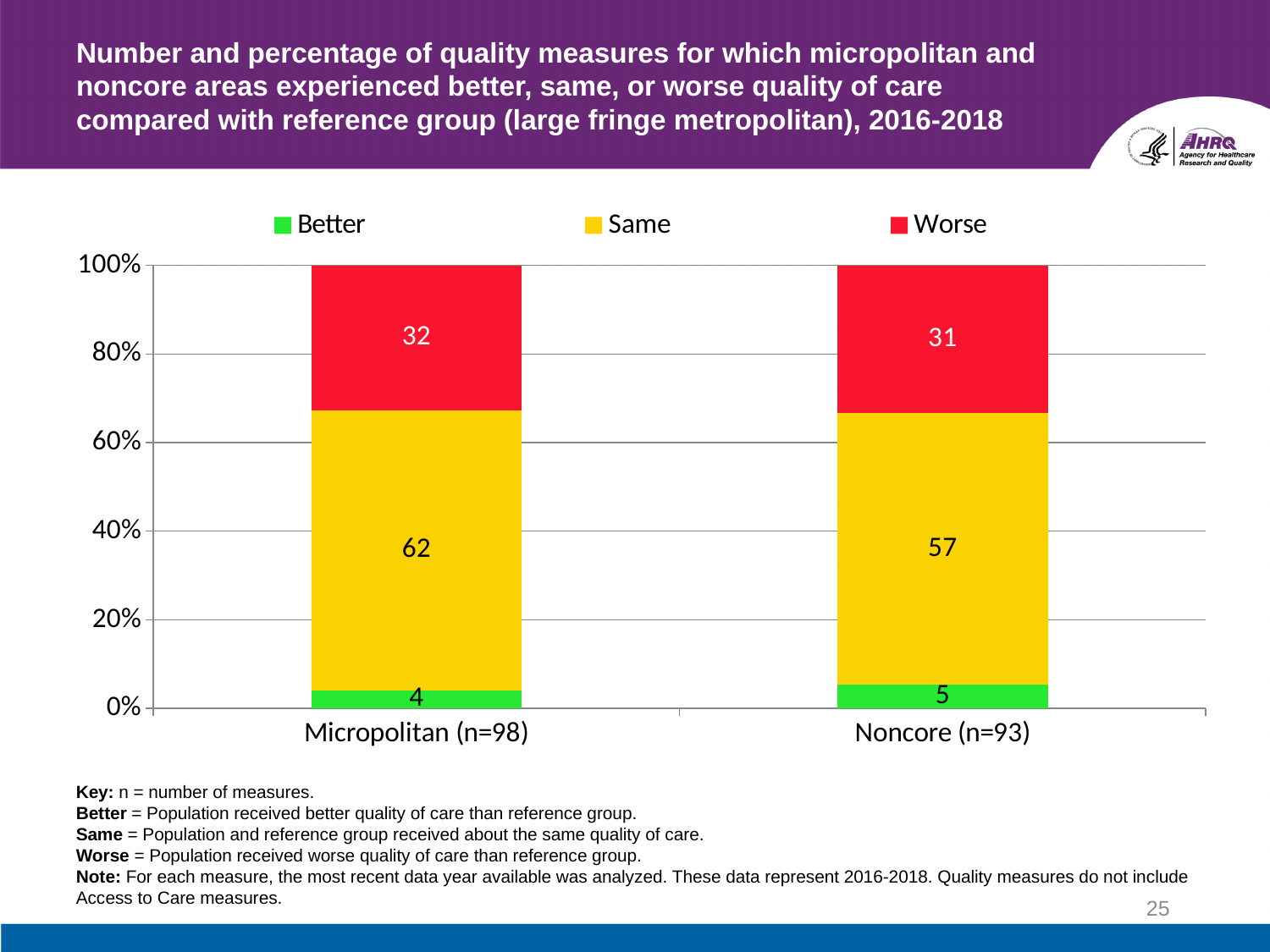
What is the difference between the number of "Worse" measures for Micropolitan (n=98) and Noncore (n=93)? 1 How many quality measures were rated "Worse" for Noncore (n=93)? 31 How many quality measures were rated "Same" for Micropolitan (n=98)? 62 What is the difference between the number of "Same" measures for Micropolitan (n=98) and Noncore (n=93)? 5 What type of chart is shown on the slide? Stacked bar chart What is the total number of measures in the Noncore bar (Better + Same + Worse)? 93 How many series does the legend list? 3 How many categories (bars) are shown on the x axis? 2 How many quality measures were rated "Better" for Micropolitan (n=98)? 4 What is the total number of measures in the Micropolitan bar (Better + Same + Worse)? 98 How many quality measures were rated "Same" for Noncore (n=93)? 57 Which category has the larger number of "Better" measures, Micropolitan (n=98) or Noncore (n=93)? Noncore (n=93)